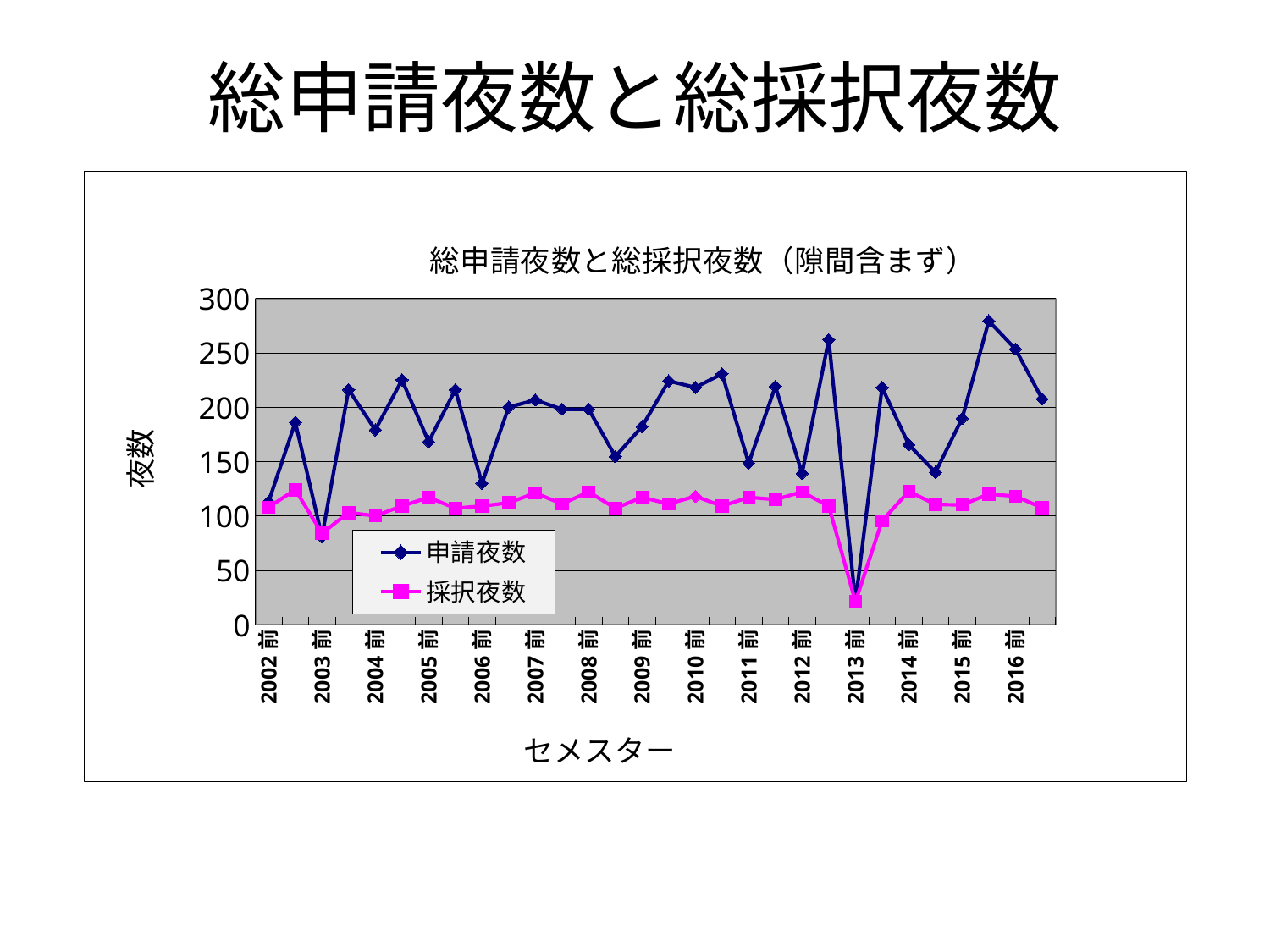
What kind of chart is shown on the slide? line chart Is the value of 申請夜数 at 2012後 (the point after 2012前) greater or less than 250? greater At 2010前, which series has the larger value, 申請夜数 or 採択夜数? 申請夜数 Is the value of 採択夜数 at 2003前 greater or less than 100? less How many series does the legend list? 2 At which semester does the 採択夜数 series reach its lowest value? 2013前 At which semester does the 申請夜数 series reach its lowest value? 2013前 Is the value of 申請夜数 at 2013前 greater or less than 50? less At which semester does the 申請夜数 series reach its highest value? 2015後 (the point after 2015前) What are the two series named in the legend? 申請夜数 and 採択夜数 How many year labels (2002 through 2016) appear along the x axis? 15 What is the label on the vertical axis of the chart? 夜数